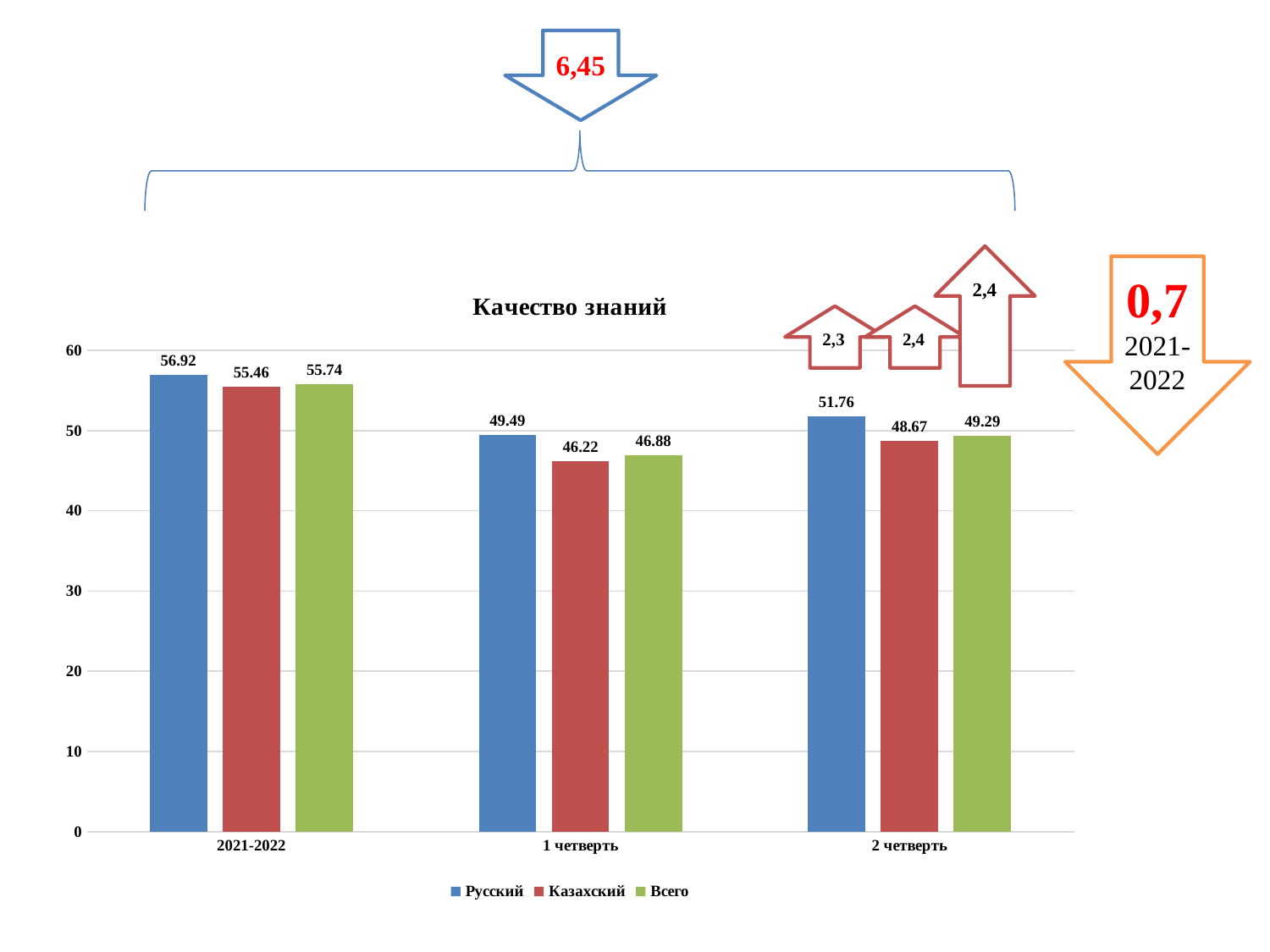
Which is larger in 2 четверть: Русский or Казахский? Русский What is the value for Казахский in 1 четверть? 46.22 What is the difference between the Русский values for 2021-2022 and 1 четверть? 7.43 What is the value for Всего in 2 четверть? 49.29 Is the value for Всего in 1 четверть greater or less than 50? less How many categories are shown on the x axis? 3 What kind of chart is shown? bar chart Which category has the highest value for Всего? 2021-2022 Which category has the lowest value for Казахский? 1 четверть How many series does the legend list? 3 What is the title of the chart? Качество знаний What is the value for Русский in 2021-2022? 56.92